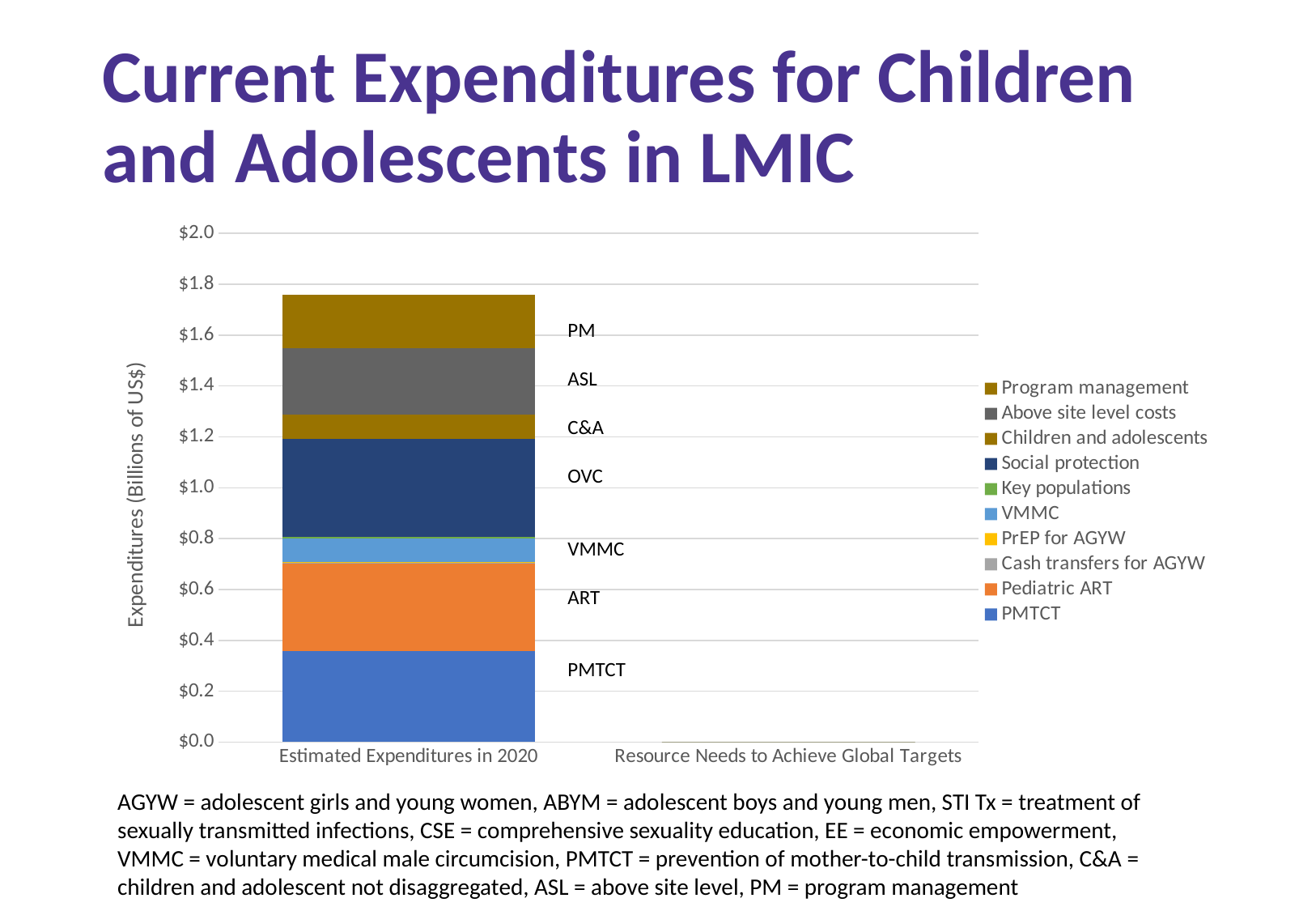
Is the PMTCT segment of the Estimated Expenditures in 2020 bar greater or less than $0.4 billion? less Is the total of the Estimated Expenditures in 2020 bar greater or less than $1.6 billion? greater Which x-axis category has the taller stacked bar? Estimated Expenditures in 2020 What kind of chart is shown on the slide? Stacked bar chart Which legend entry is listed first (at the top of the legend)? Program management Is the total of the Estimated Expenditures in 2020 bar greater or less than $2.0 billion? less What is the label of the y axis? Expenditures (Billions of US$) In the Estimated Expenditures in 2020 bar, which segment is larger: PMTCT or VMMC? PMTCT In the Estimated Expenditures in 2020 bar, which segment is larger: Above site level costs or Children and adolescents? Above site level costs How many series does the legend list? 10 How many categories are shown on the x axis? 2